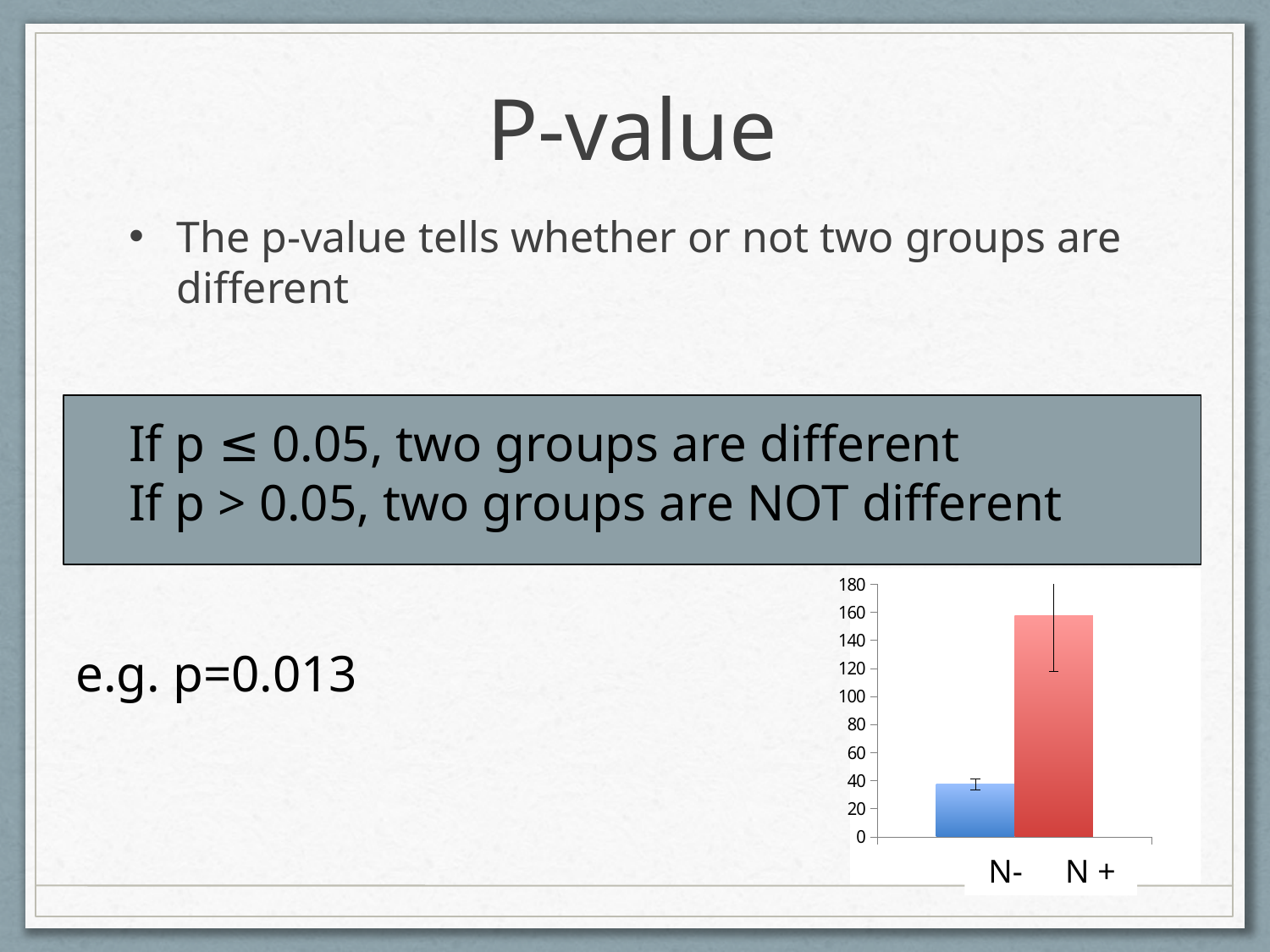
What colour is the bar for N +? red Is the value for N- greater or less than 20? greater Is the value for N + greater or less than 180? less Which category has the highest bar in the chart? N + Which category has the lowest bar in the chart? N- Which bar is taller, N- or N +? N + How many categories are plotted in the bar chart? 2 What is the highest value shown on the chart's vertical axis? 180 Is the value for N- greater or less than 60? less What kind of chart is shown on the slide? bar chart